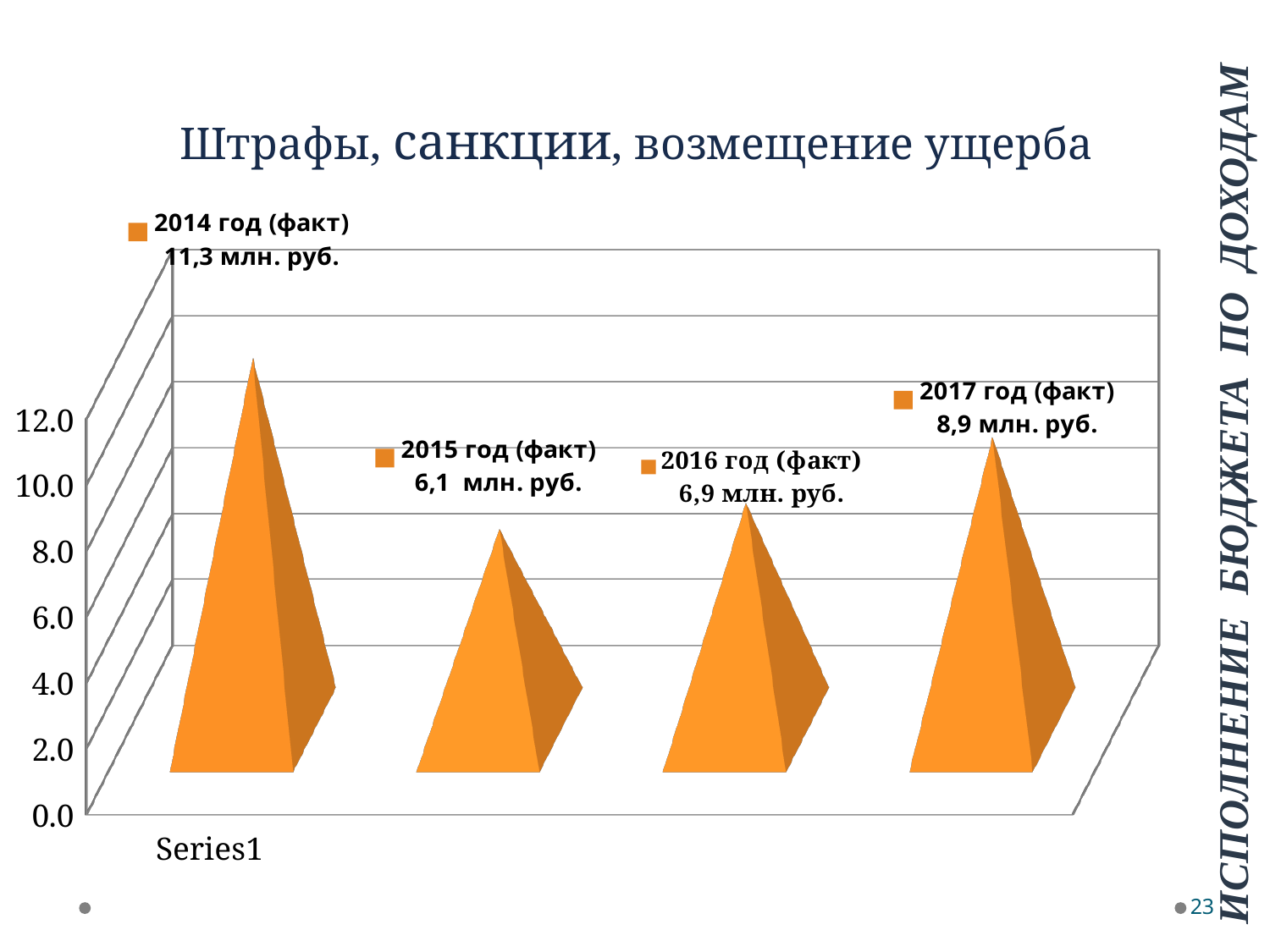
What is the difference between the 2014 and 2017 values? 2,4 млн. руб. Which year has the lowest value? 2015 год (факт) What is the value for 2016 год (факт)? 6,9 млн. руб. Which year has the highest value? 2014 год (факт) What is the difference between the 2016 and 2015 values? 0,8 млн. руб. What is the value for 2017 год (факт)? 8,9 млн. руб. How many bars are shown in the chart? 4 Which is larger, the value for 2016 or the value for 2017? 2017 What is the value for 2014 год (факт)? 11,3 млн. руб. What is the value for 2015 год (факт)? 6,1 млн. руб. What is the title of the chart? Штрафы, санкции, возмещение ущерба What kind of chart is shown on the slide? Bar chart